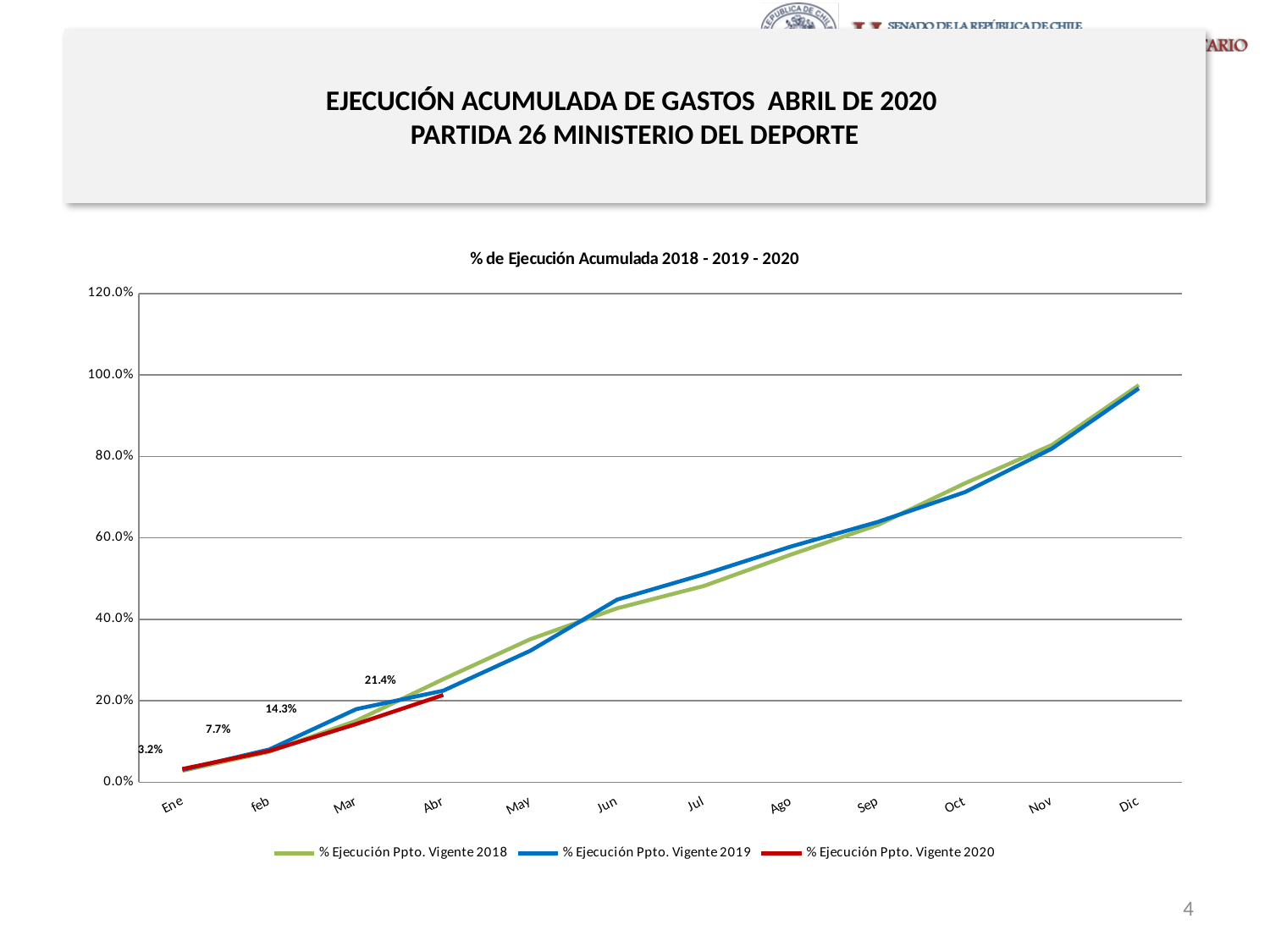
What is the value of % Ejecución Ppto. Vigente 2020 for Ene? 3.2% What kind of chart is shown on the slide? Line chart What is the value of % Ejecución Ppto. Vigente 2020 for Mar? 14.3% What is the value of % Ejecución Ppto. Vigente 2020 for Abr? 21.4% Do the values for % Ejecución Ppto. Vigente 2019 rise or fall from Ene to Dic? Rise What is the difference between the 2020 values for Feb and Ene? 4.5% How many months are shown on the x axis? 12 Is the value for % Ejecución Ppto. Vigente 2019 in Dic greater or less than 80.0%? greater How many series does the legend list? 3 What colour is the line for % Ejecución Ppto. Vigente 2020? Red Which month has the highest value for % Ejecución Ppto. Vigente 2020? Abr What is the difference between the 2020 values for Abr and Mar? 7.1%